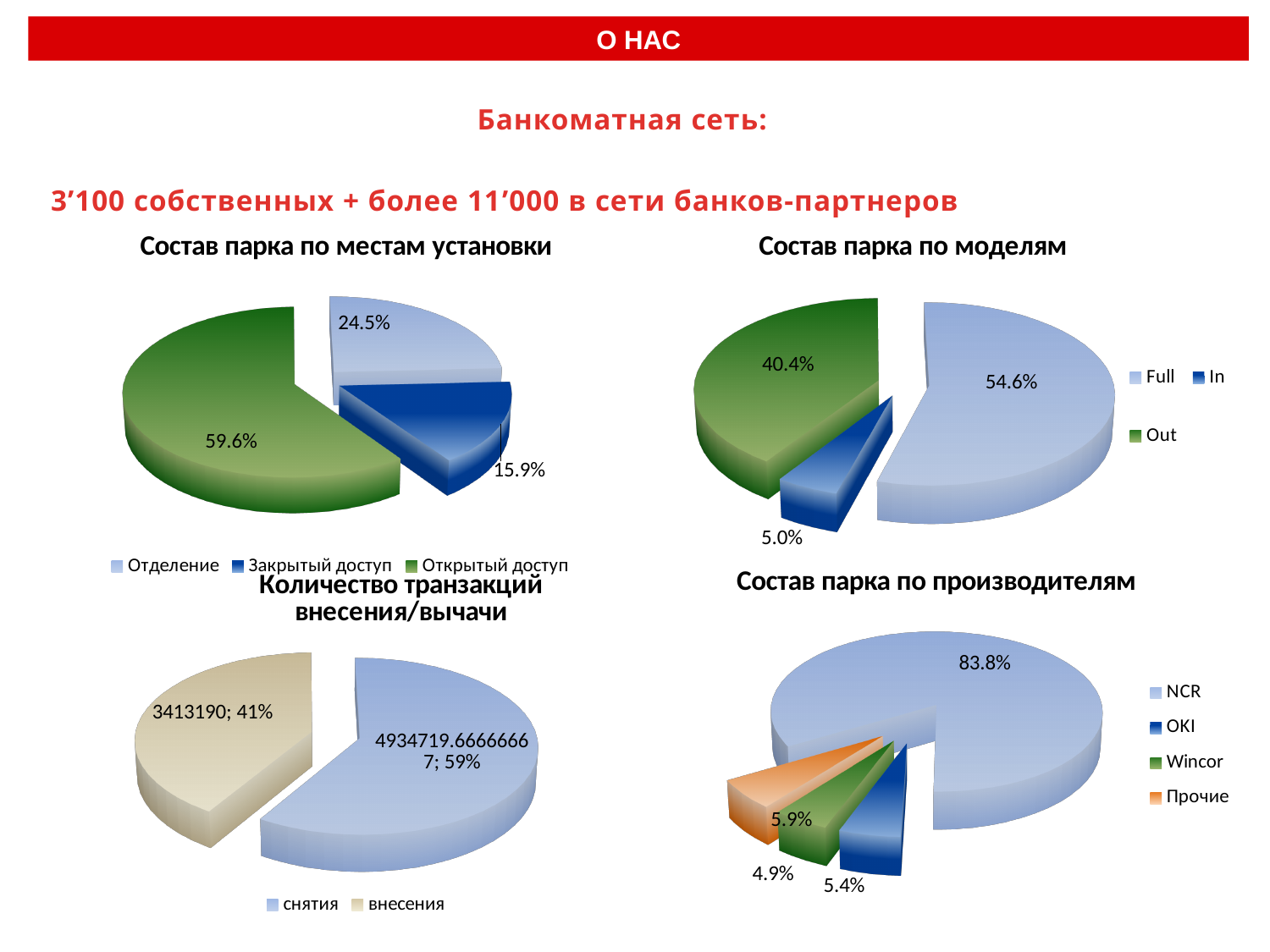
In the chart titled 'Состав парка по местам установки', what is the difference between the shares of 'Отделение' and 'Закрытый доступ'? 8.6% In the chart titled 'Состав парка по местам установки', what share does 'Открытый доступ' have? 59.6% What type of chart is 'Состав парка по производителям'? Pie chart In the chart titled 'Состав парка по моделям', which category has the largest share? Full In the chart titled 'Состав парка по моделям', what share does 'Full' have? 54.6% In the chart titled 'Количество транзакций внесения/вычачи', which category is larger, 'снятия' or 'внесения'? снятия In the chart titled 'Состав парка по производителям', what share does 'NCR' have? 83.8% In the chart titled 'Состав парка по производителям', which manufacturer has the smallest share? Wincor In the chart titled 'Состав парка по моделям', how many categories does the legend list? 3 In the chart titled 'Состав парка по местам установки', which category has the smallest share? Закрытый доступ In the chart titled 'Количество транзакций внесения/вычачи', what value is shown for 'внесения'? 3413190; 41% In the chart titled 'Состав парка по производителям', what is the difference between the shares of 'Прочие' and 'OKI'? 0.5%